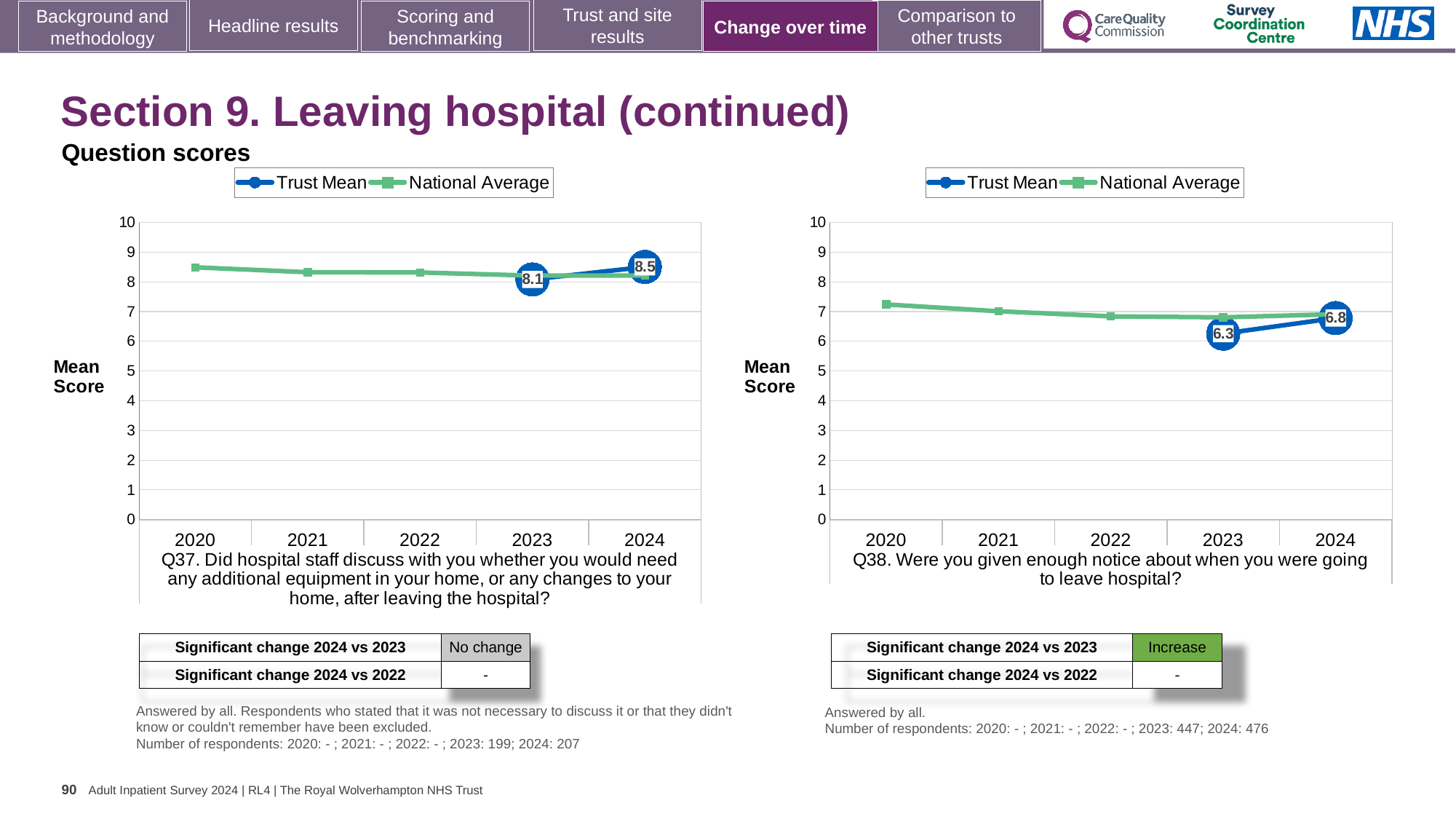
In the Q38 chart (right), did the Trust Mean rise or fall from 2023 to 2024? rise In the Q37 chart (left), what is the Trust Mean score for 2023? 8.1 In the Q37 chart (left), by how much did the Trust Mean change from 2023 to 2024? 0.4 In the Q38 chart (right), what is the difference between the Trust Mean for 2024 and 2023? 0.5 In the Q38 chart (right), is the National Average for 2020 greater or less than 7? greater In the Q37 chart (left), is the Trust Mean for 2024 greater or less than the Trust Mean for 2023? greater In the Q37 chart (left), what is the Trust Mean score for 2024? 8.5 In the Q38 chart (right), what is the Trust Mean score for 2024? 6.8 How many series does the legend of the Q37 chart (left) list? 2 How many years are shown on the x axis of the Q38 chart (right)? 5 What kind of chart is the Q37 chart (left)? line chart In the Q38 chart (right), what is the Trust Mean score for 2023? 6.3